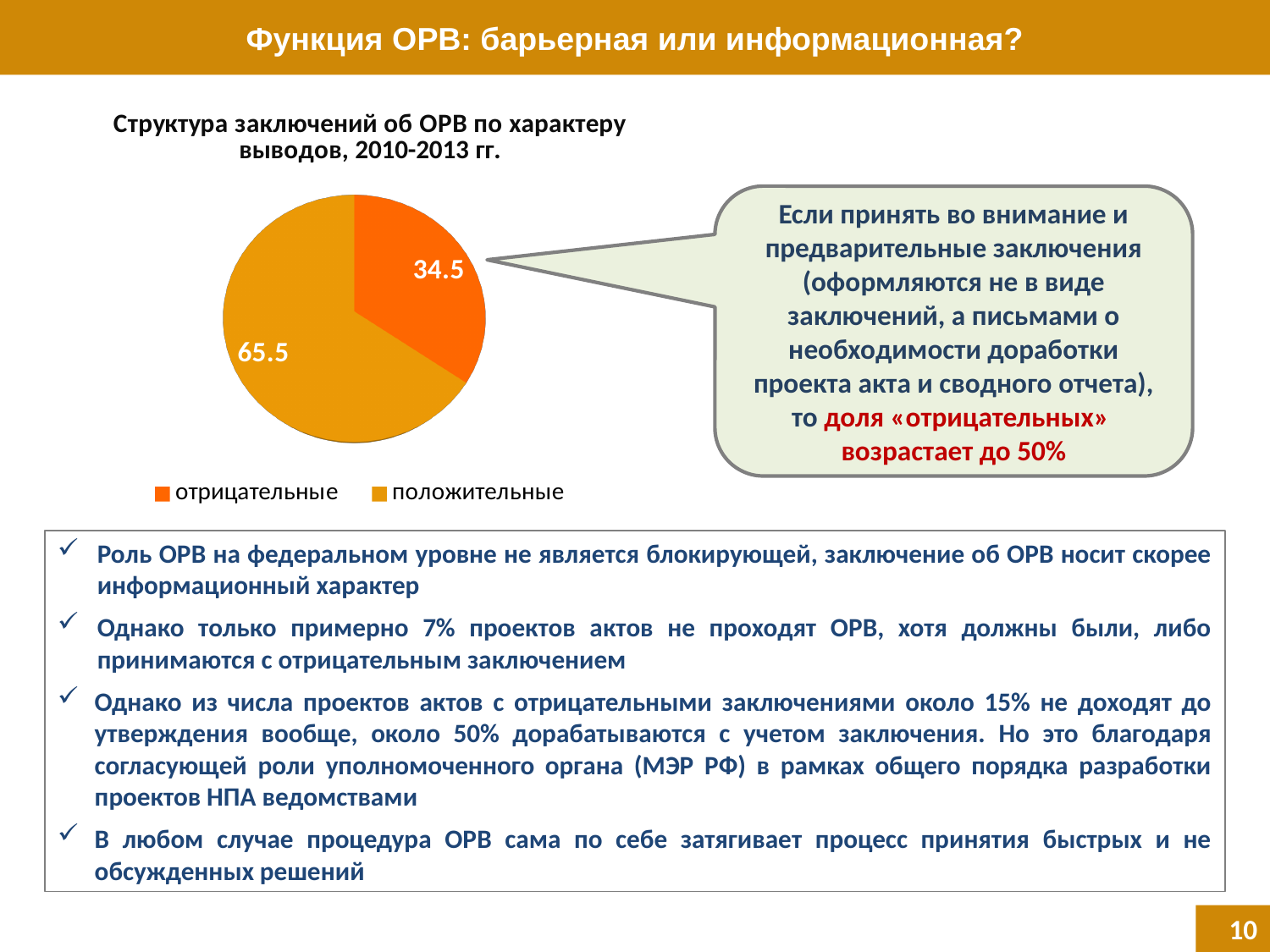
Which legend entry is shown in the darker orange colour in the pie chart? отрицательные Is the value for положительные greater or less than 50? greater What is the value for отрицательные in the pie chart? 34.5 What is the value for положительные in the pie chart? 65.5 Which category has the largest slice in the pie chart? положительные How many entries does the legend of the pie chart list? 2 Which category has the smallest slice in the pie chart? отрицательные What is the title of the pie chart? Структура заключений об ОРВ по характеру выводов, 2010-2013 гг. What is the difference between the values for положительные and отрицательные? 31 What type of chart is shown on the slide? pie chart How many slices does the pie chart have? 2 Which is larger, the value for отрицательные or the value for положительные? положительные